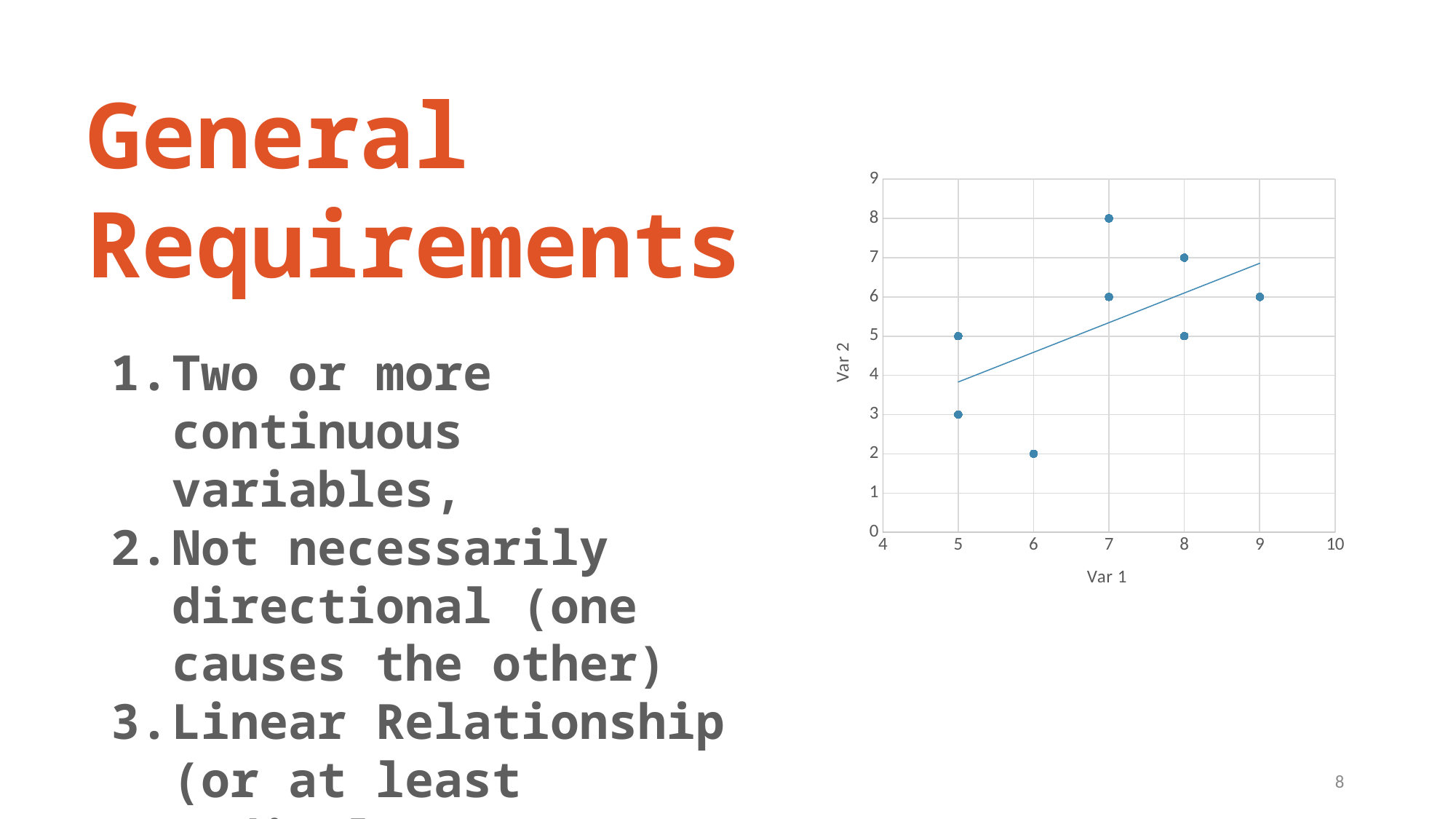
How many data points are plotted in the chart? 8 What kind of chart is shown on the slide? scatter chart What is the highest Var 2 value among the plotted points? 8 Is the Var 2 value of the point at Var 1 = 6 greater or less than 4? less What is the Var 2 value of the point plotted at Var 1 = 6? 2 What is the label of the x axis of the chart? Var 1 How many points are plotted at Var 1 = 5? 2 What is the lowest Var 2 value among the plotted points? 2 What is the difference between the highest and lowest Var 2 values plotted? 6 What is the Var 2 value of the point plotted at Var 1 = 9? 6 What is the label of the y axis of the chart? Var 2 Does the trend line in the chart rise or fall as Var 1 increases? rise